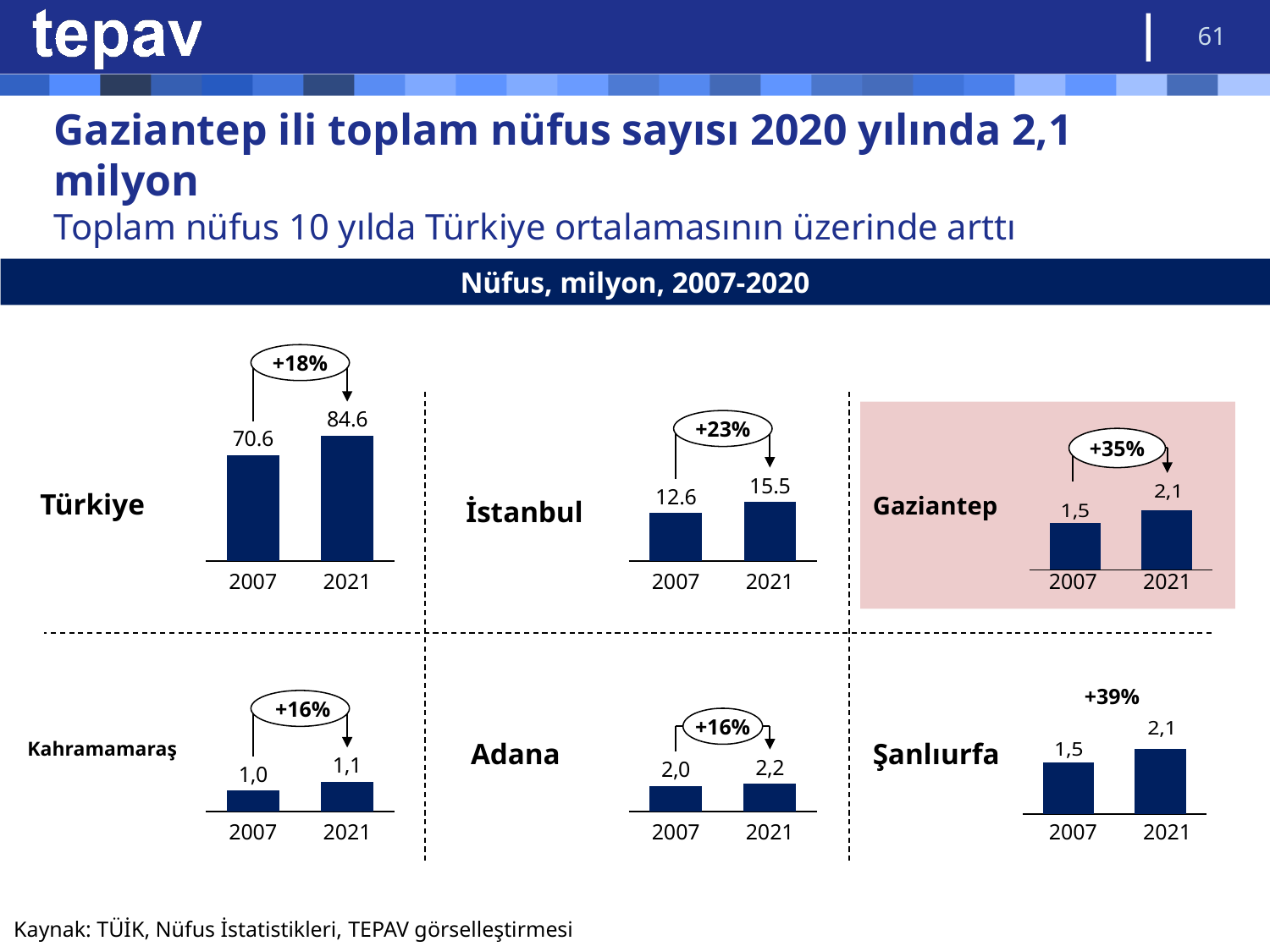
In the Kahramanmaraş chart, which year has the higher value, 2007 or 2021? 2021 What type of chart is used for the Türkiye panel? bar chart In the Türkiye chart, what is the difference between the 2021 and 2007 values? 14.0 In the Adana chart, what is the value shown for 2007? 2,0 In the Gaziantep chart, what is the value shown for 2021? 2,1 How many bars are shown in the Gaziantep chart? 2 What percentage change is shown above the Gaziantep chart? +35% In the Şanlıurfa chart, do the values rise or fall from 2007 to 2021? rise In the İstanbul chart, what is the difference between the 2021 and 2007 values? 2.9 In the İstanbul chart, what is the value shown for 2007? 12.6 What percentage change is shown above the Şanlıurfa chart? +39% In the Türkiye chart, what is the population value shown for 2021? 84.6